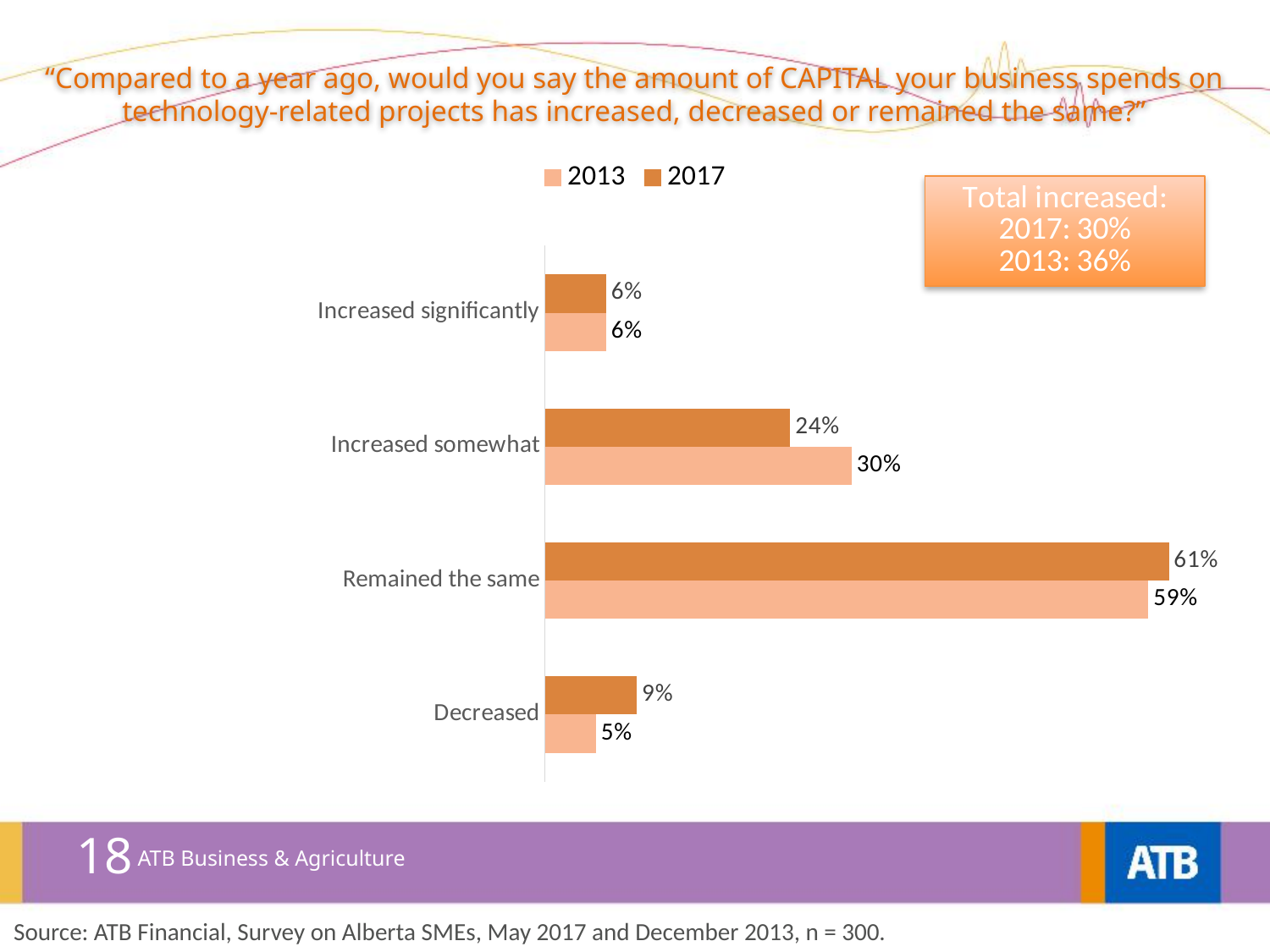
Which category has the lowest value for 2013? Decreased What percentage of businesses said capital spending 'Remained the same' in 2013? 59% Which category has the highest value for 2017? Remained the same What percentage of businesses reported 'Decreased' capital spending in 2017? 9% For 'Remained the same', which year has the larger value, 2013 or 2017? 2017 How many series does the legend list? 2 According to the text box, what was the total percentage of businesses reporting increased capital spending in 2013? 36% What is the difference between the 2017 and 2013 values for 'Decreased'? 4% What percentage of businesses said capital spending on technology-related projects 'Increased somewhat' in 2017? 24% What kind of chart is shown on the slide? Bar chart How many response categories are shown on the chart? 4 What is the difference between the 2013 and 2017 values for 'Increased somewhat'? 6%